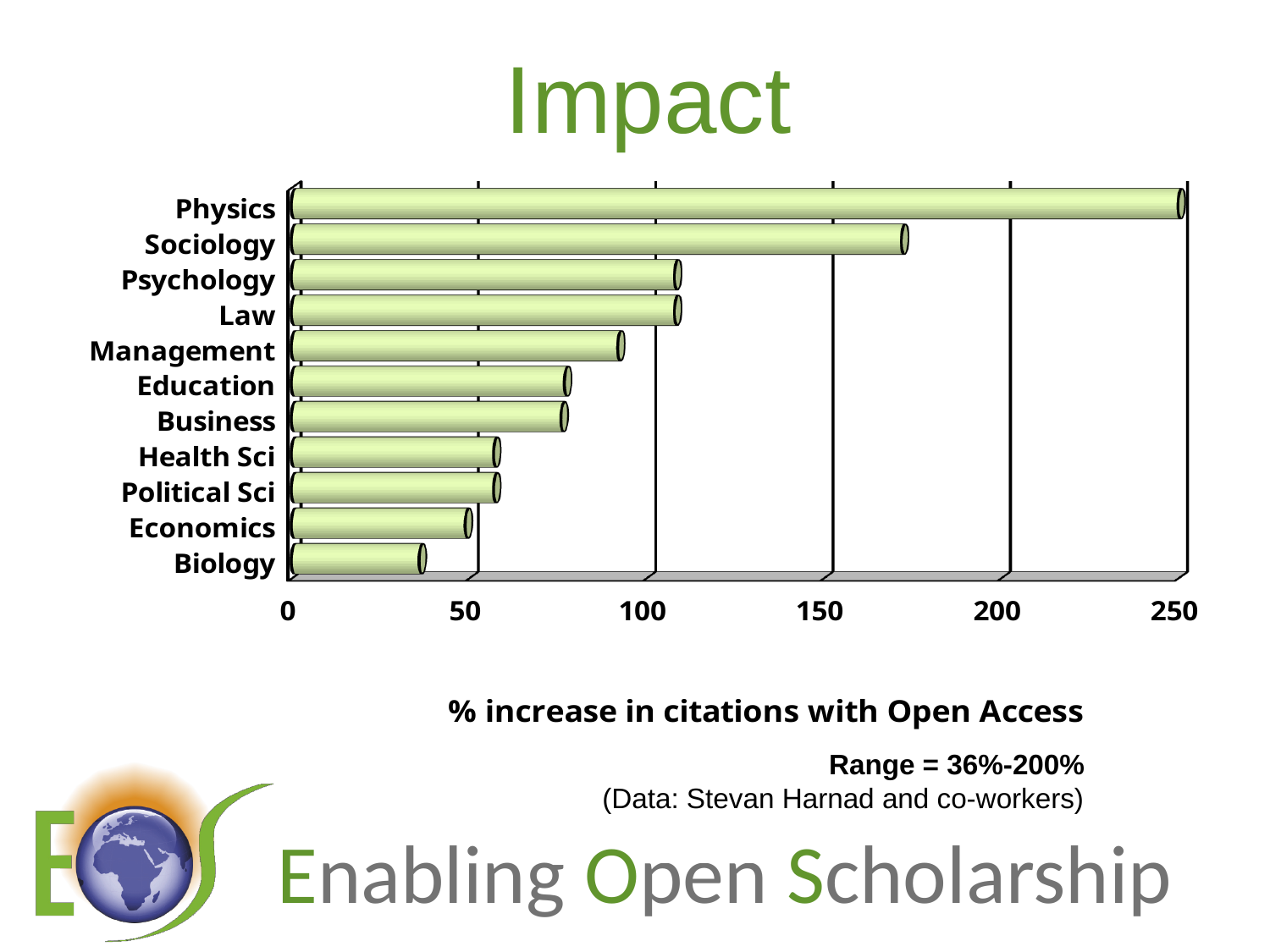
Is the value for Education greater or less than 100? less What kind of chart is shown on the slide? bar chart Is the value for Psychology greater or less than 100? greater Which discipline has the highest % increase in citations with Open Access? Physics Which has a larger value, Management or Education? Management Is the value for Management greater or less than 100? less Which discipline has the lowest % increase in citations with Open Access? Biology Which has a larger value, Sociology or Psychology? Sociology How many disciplines are plotted in the chart? 11 What quantity does the chart measure, according to the caption below it? % increase in citations with Open Access